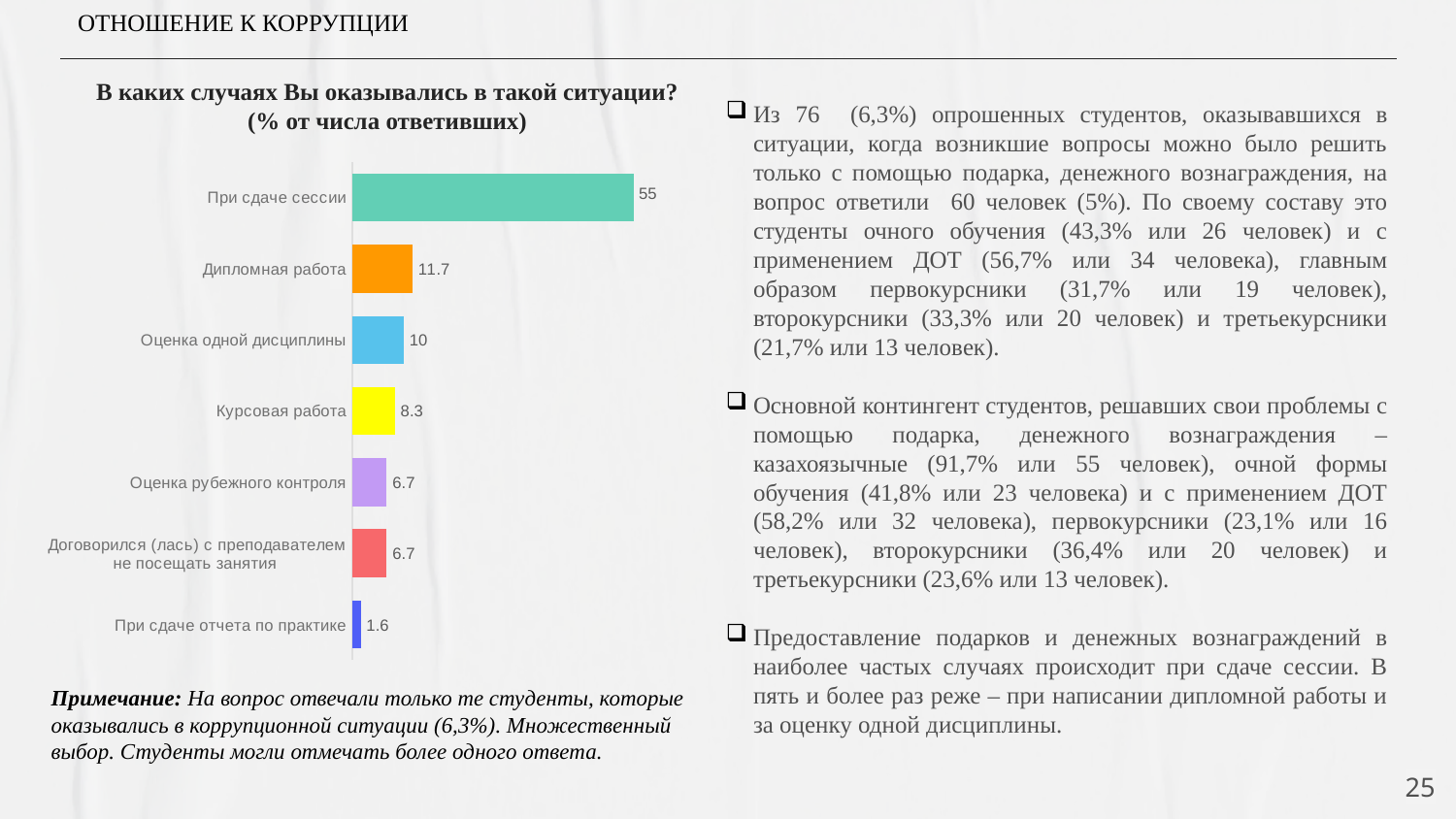
What is the difference between the values for "Оценка одной дисциплины" and "Курсовая работа"? 1.7 What value is shown for "Дипломная работа"? 11.7 What is the title of the chart? В каких случаях Вы оказывались в такой ситуации? (% от числа ответивших) What value is shown for "При сдаче отчета по практике"? 1.6 What type of chart is shown on the slide? Bar chart Which category has the lowest value? При сдаче отчета по практике How many categories are shown in the chart? 7 Which is larger, the value for "Дипломная работа" or the value for "Оценка одной дисциплины"? Дипломная работа Which category has the highest value? При сдаче сессии What is the difference between the values for "При сдаче сессии" and "Дипломная работа"? 43.3 What value is shown for "Курсовая работа"? 8.3 What value is shown for "При сдаче сессии"? 55